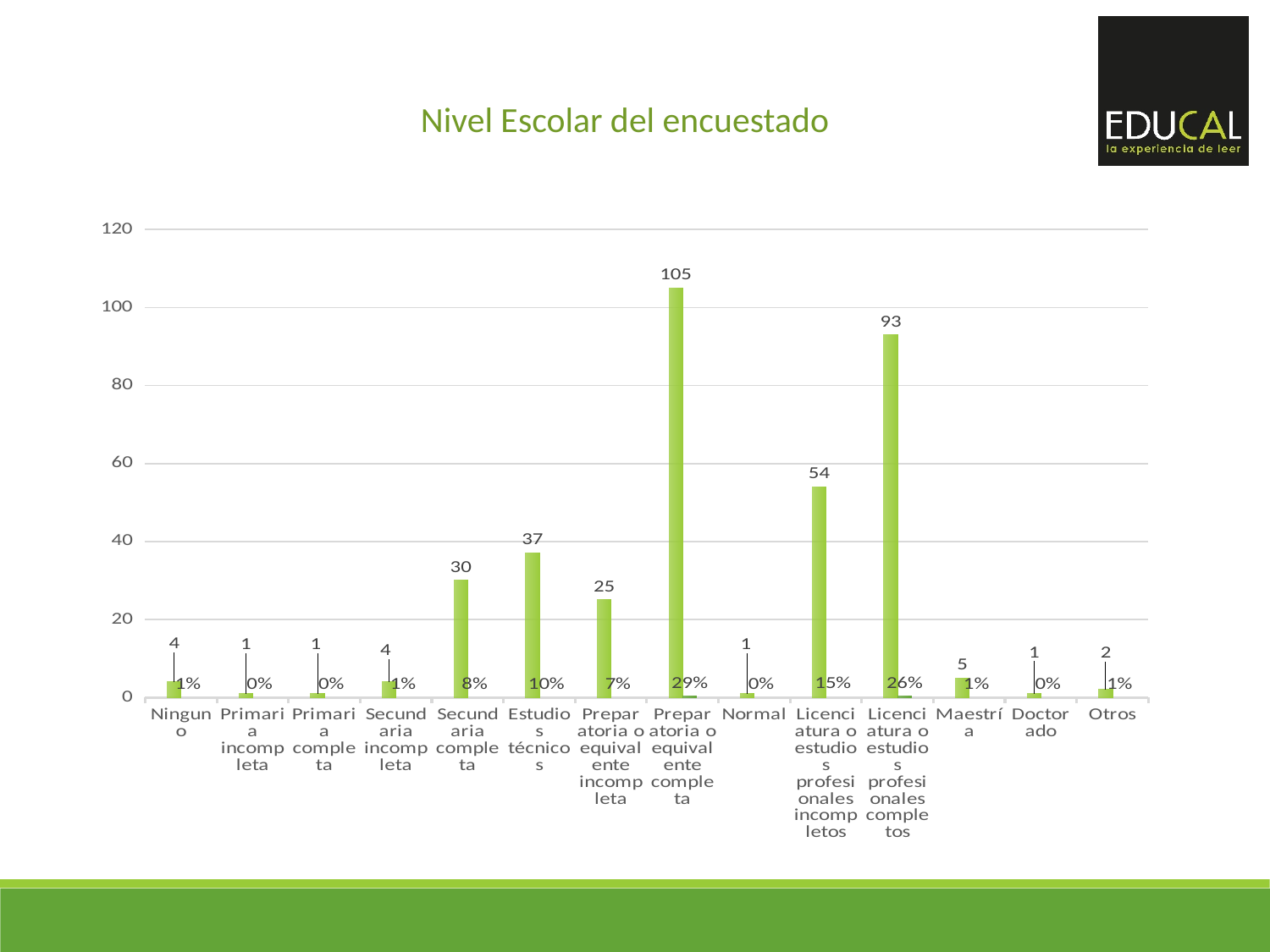
What is the count for Maestría? 5 How many categories are shown on the x axis? 14 What is the count for Licenciatura o estudios profesionales completos? 93 What kind of chart is shown on the slide? Bar chart Is the count for Licenciatura o estudios profesionales incompletos greater or less than 40? greater What is the count for Preparatoria o equivalente completa? 105 Which has a higher count, Estudios técnicos or Preparatoria o equivalente incompleta? Estudios técnicos What is the count for Secundaria completa? 30 What is the difference between the counts for Preparatoria o equivalente completa and Licenciatura o estudios profesionales completos? 12 What percentage is shown for Estudios técnicos? 10% What is the title of the chart? Nivel Escolar del encuestado Which category has the highest count? Preparatoria o equivalente completa